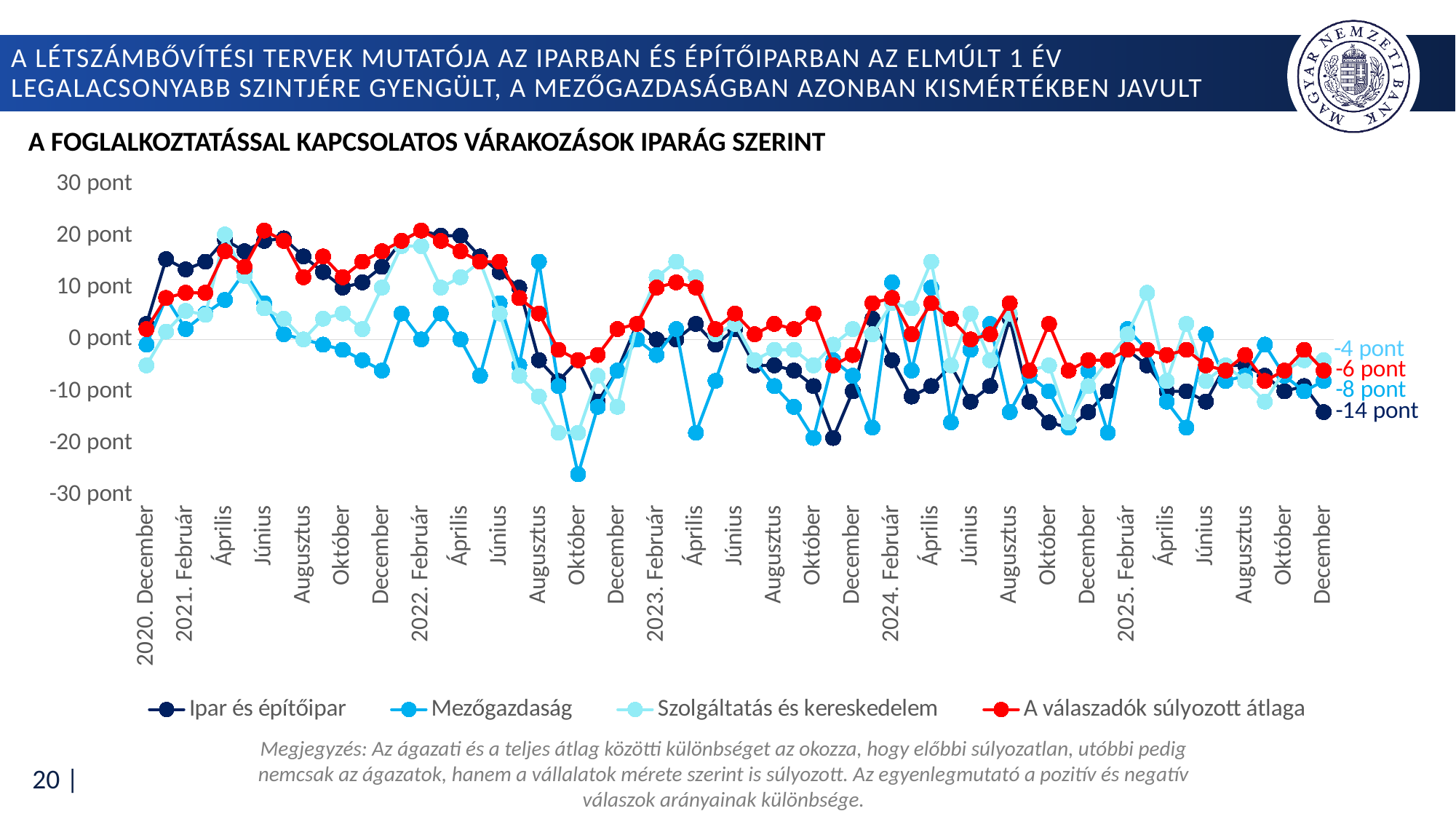
What kind of chart is shown on the slide? Line chart Is the value for Mezőgazdaság in 2022 Október greater or less than -20 pont? less What is the value for Ipar és építőipar at 2025 December, as labelled at the end of the line? -14 pont What is the value for A válaszadók súlyozott átlaga at 2025 December, as labelled at the end of the line? -6 pont What is the value for Szolgáltatás és kereskedelem at 2025 December, as labelled at the end of the line? -4 pont How many series does the legend list? 4 Is the value for Ipar és építőipar in 2021 Június greater or less than 10 pont? greater Which series has the lowest value at 2025 December? Ipar és építőipar Which series has the highest value at 2025 December? Szolgáltatás és kereskedelem At 2025 December, which is larger: the value for Mezőgazdaság or the value for Ipar és építőipar? Mezőgazdaság What is the value for Mezőgazdaság at 2025 December, as labelled at the end of the line? -8 pont What is the difference between the Szolgáltatás és kereskedelem value and the Ipar és építőipar value at 2025 December? 10 pont